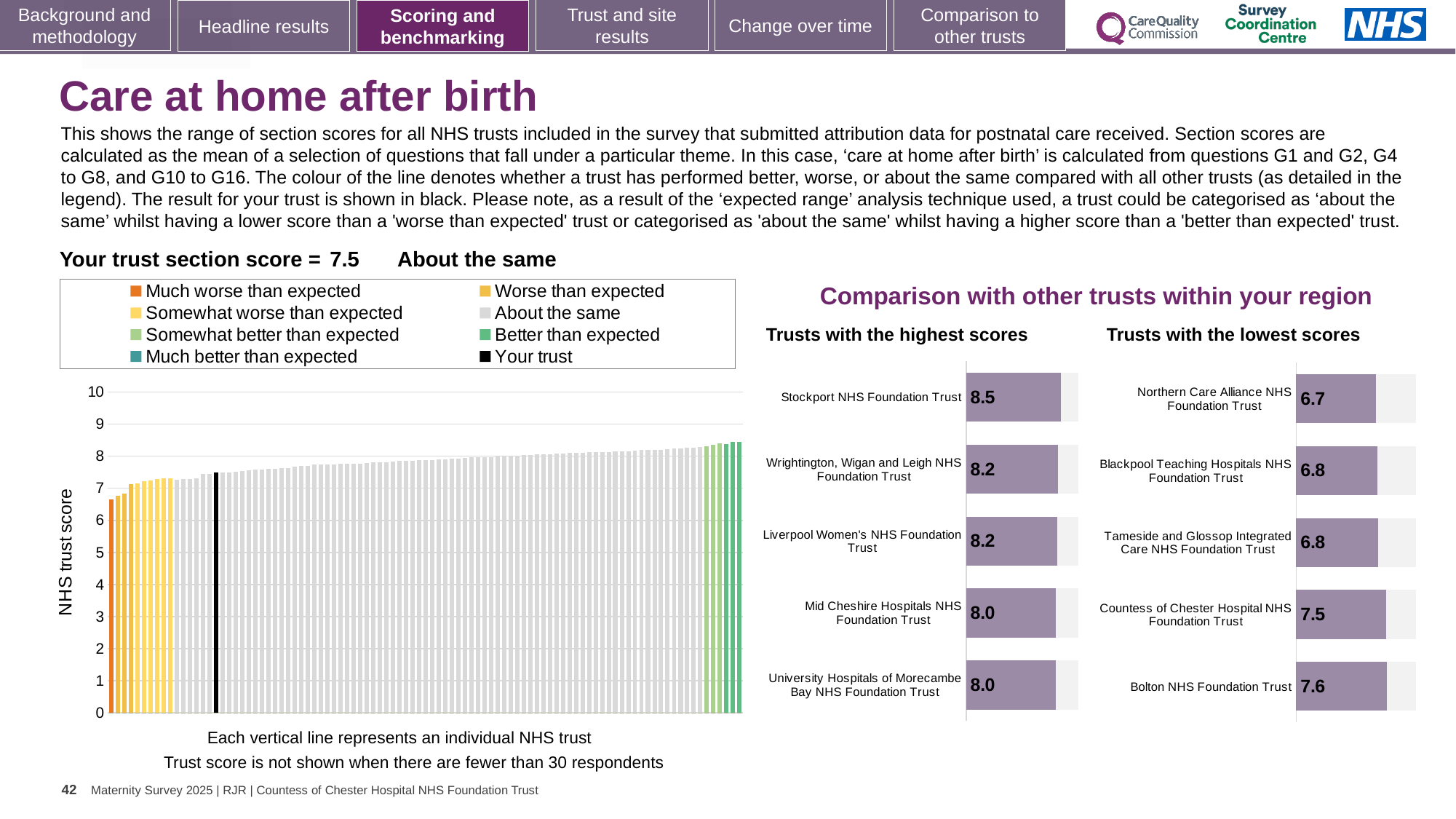
In the 'Trusts with the lowest scores' chart, what is the score for Bolton NHS Foundation Trust? 7.6 How many entries does the legend of the main 'NHS trust score' chart on the left list? 8 In the 'Trusts with the highest scores' chart, which trust has the highest score? Stockport NHS Foundation Trust In the 'Trusts with the highest scores' chart, what is the score for Stockport NHS Foundation Trust? 8.5 In the 'Trusts with the lowest scores' chart, what is the difference between the scores of Bolton NHS Foundation Trust and Northern Care Alliance NHS Foundation Trust? 0.9 In the 'Trusts with the lowest scores' chart, which has the larger score: Countess of Chester Hospital NHS Foundation Trust or Blackpool Teaching Hospitals NHS Foundation Trust? Countess of Chester Hospital NHS Foundation Trust How many trusts are shown in the 'Trusts with the highest scores' chart? 5 In the 'Trusts with the highest scores' chart, what is the difference between the scores of Stockport NHS Foundation Trust and University Hospitals of Morecambe Bay NHS Foundation Trust? 0.5 In the main 'NHS trust score' chart on the left, do the values rise or fall from left to right? Rise What kind of chart is the main 'NHS trust score' chart on the left of the slide? Bar chart In the 'Trusts with the lowest scores' chart, what is the score for Tameside and Glossop Integrated Care NHS Foundation Trust? 6.8 In the 'Trusts with the lowest scores' chart, which trust has the lowest score? Northern Care Alliance NHS Foundation Trust